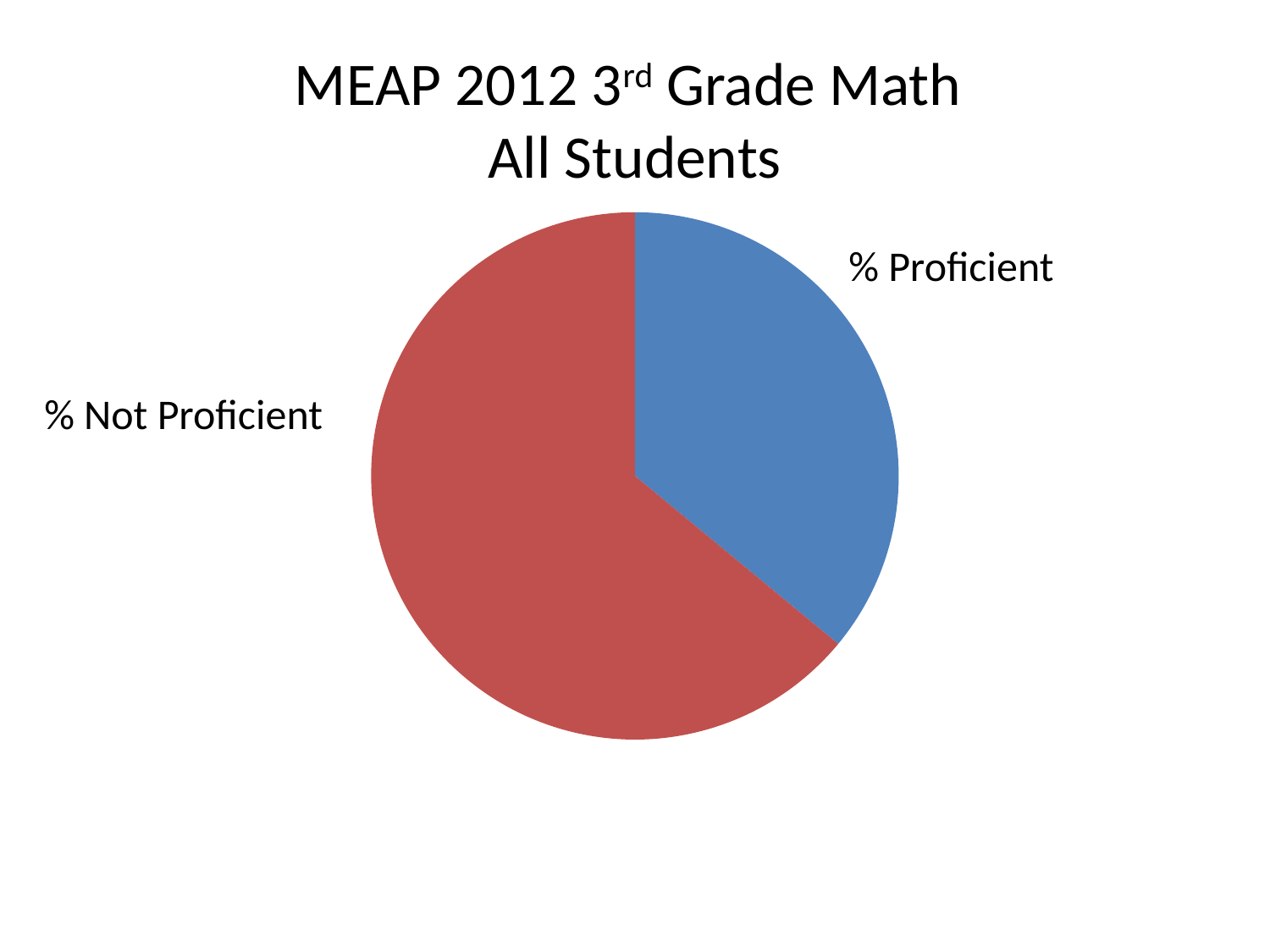
Which slice of the pie chart is the smallest? % Proficient What colour is the % Proficient slice? Blue What is the title of the chart? MEAP 2012 3rd Grade Math All Students What kind of chart is shown on the slide? Pie chart Which is larger, the % Proficient slice or the % Not Proficient slice? % Not Proficient How many slices does the pie chart have? 2 Does the % Not Proficient slice take up more or less than half of the pie? More Which slice of the pie chart is the largest? % Not Proficient